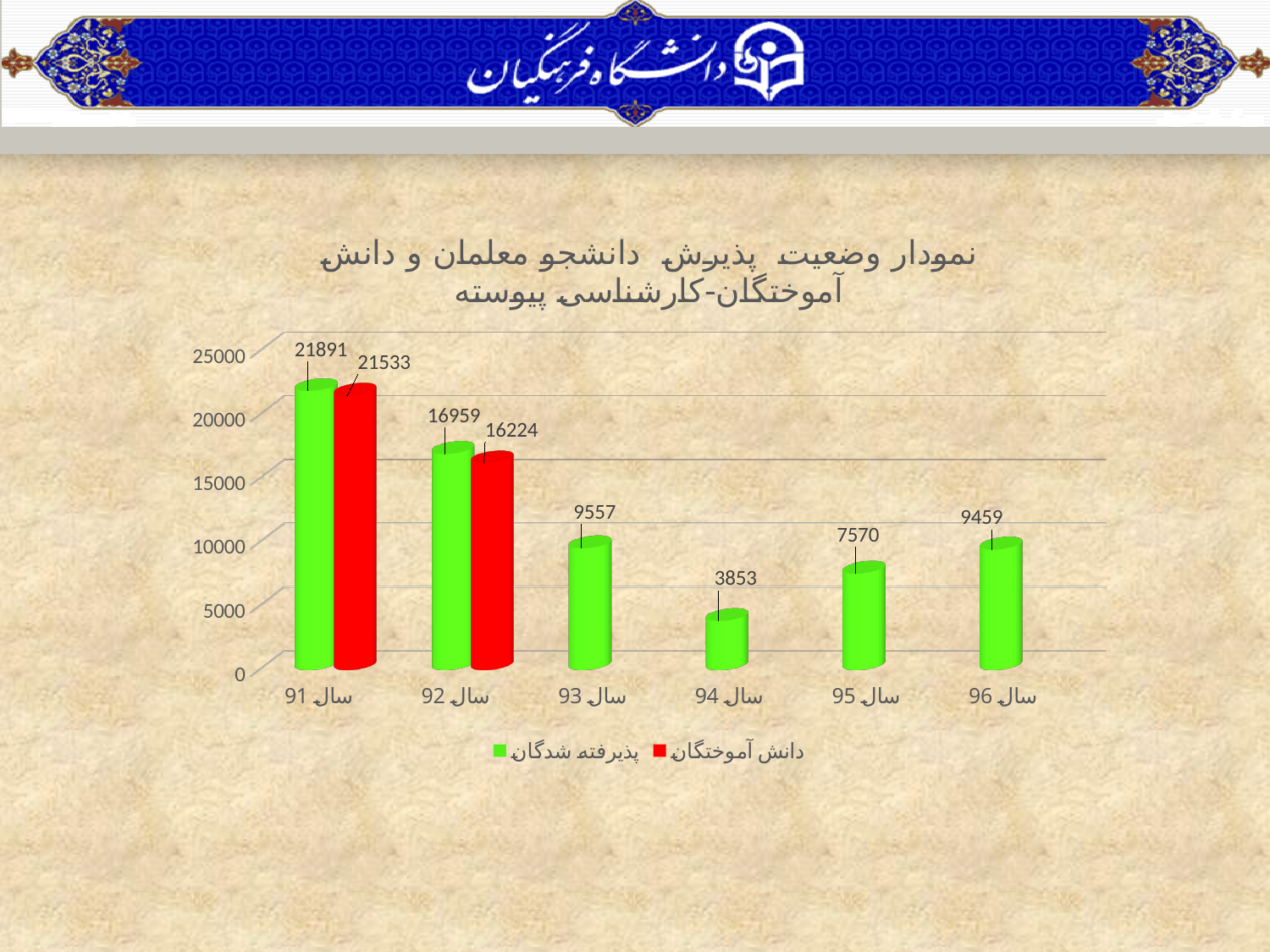
How many series does the legend list? 2 What is the value for پذیرفته شدگان in سال 91? 21891 Which colour represents دانش آموختگان in the chart? Red How many years are shown on the x axis? 6 What is the value for دانش آموختگان in سال 92? 16224 Which year has the lowest value for پذیرفته شدگان? سال 94 What is the difference between پذیرفته شدگان and دانش آموختگان in سال 91? 358 Which is larger: پذیرفته شدگان in سال 95 or in سال 96? سال 96 Which year has the highest value for پذیرفته شدگان? سال 91 What is the difference between پذیرفته شدگان in سال 92 and سال 93? 7402 What kind of chart is shown on the slide? Bar chart What is the value for پذیرفته شدگان in سال 94? 3853